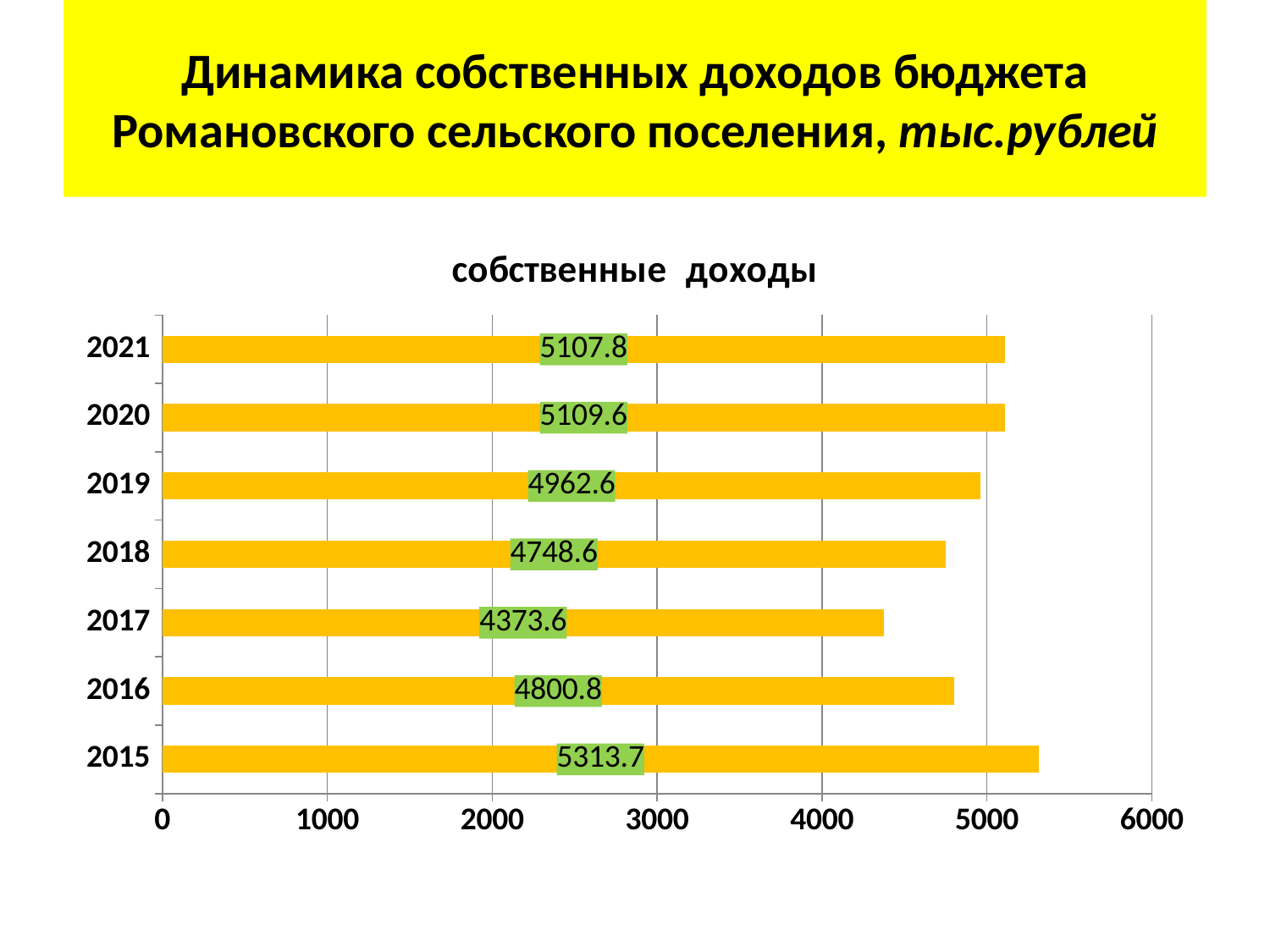
What is the difference between the values for 2019 and 2018? 214.0 What is the title of the chart? собственные доходы Is the value for 2017 greater or less than 5000? less Which is larger, the value for 2016 or the value for 2018? 2016 What is the value for 2017? 4373.6 Which year has the highest value? 2015 What kind of chart is this? bar chart What is the value for 2021? 5107.8 Which year has the lowest value? 2017 What is the value for 2015? 5313.7 How many years are shown on the chart? 7 What is the difference between the values for 2015 and 2017? 940.1